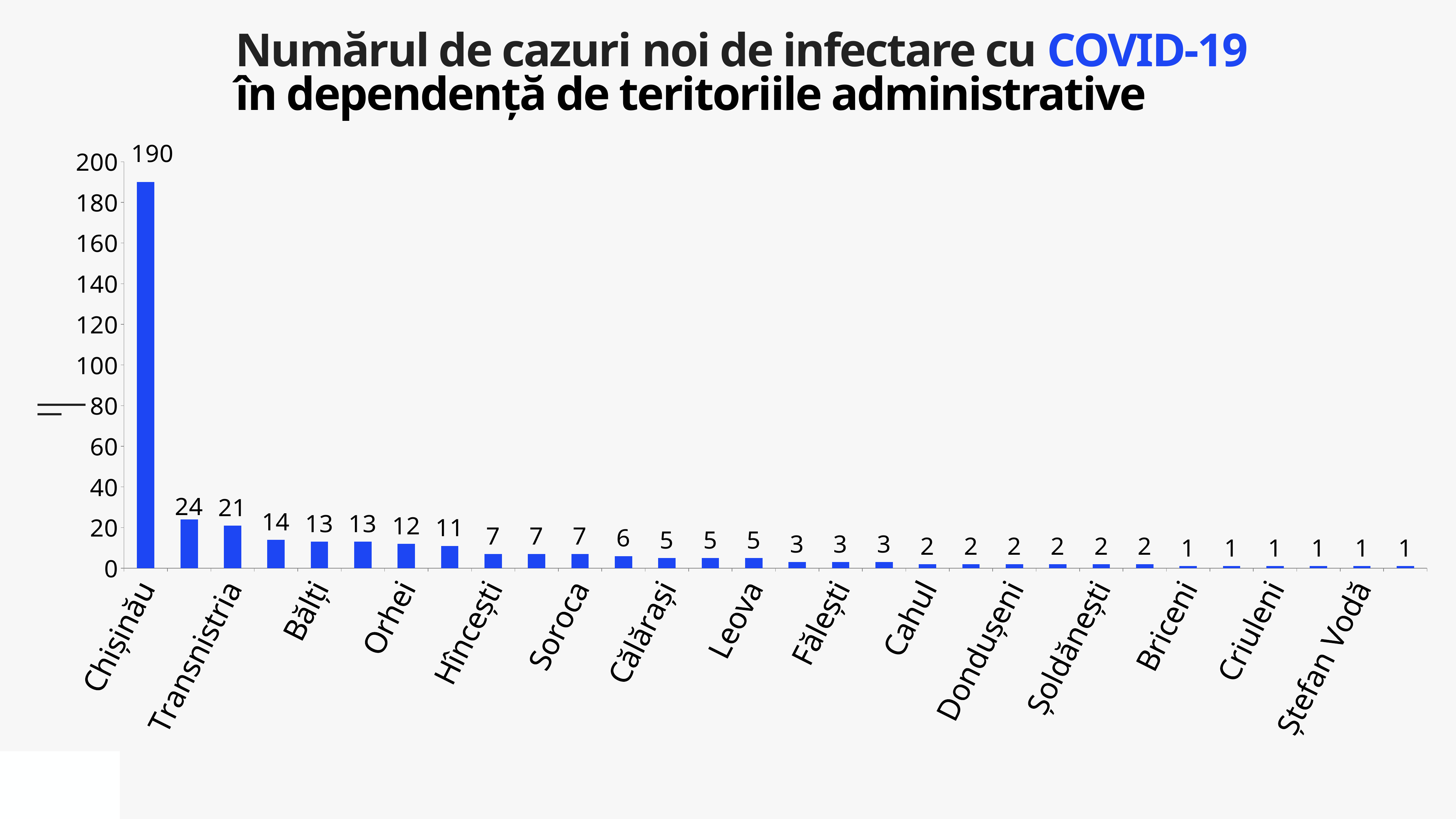
What colour are the bars in the chart? blue What is the value for Orhei? 12 What is the difference between the highest bar (190) and the second-highest bar (24)? 166 How many bars are plotted in the chart? 30 What kind of chart is shown on the slide? bar chart What is the value for Ștefan Vodă? 1 What is the highest value shown on the y axis? 200 Do the values rise or fall from left to right along the x axis? fall What is the value for Chișinău? 190 Is the value for Chișinău greater or less than 180? greater Which is larger, the value for Chișinău or the value for Transnistria? Chișinău Which category has the highest value? Chișinău